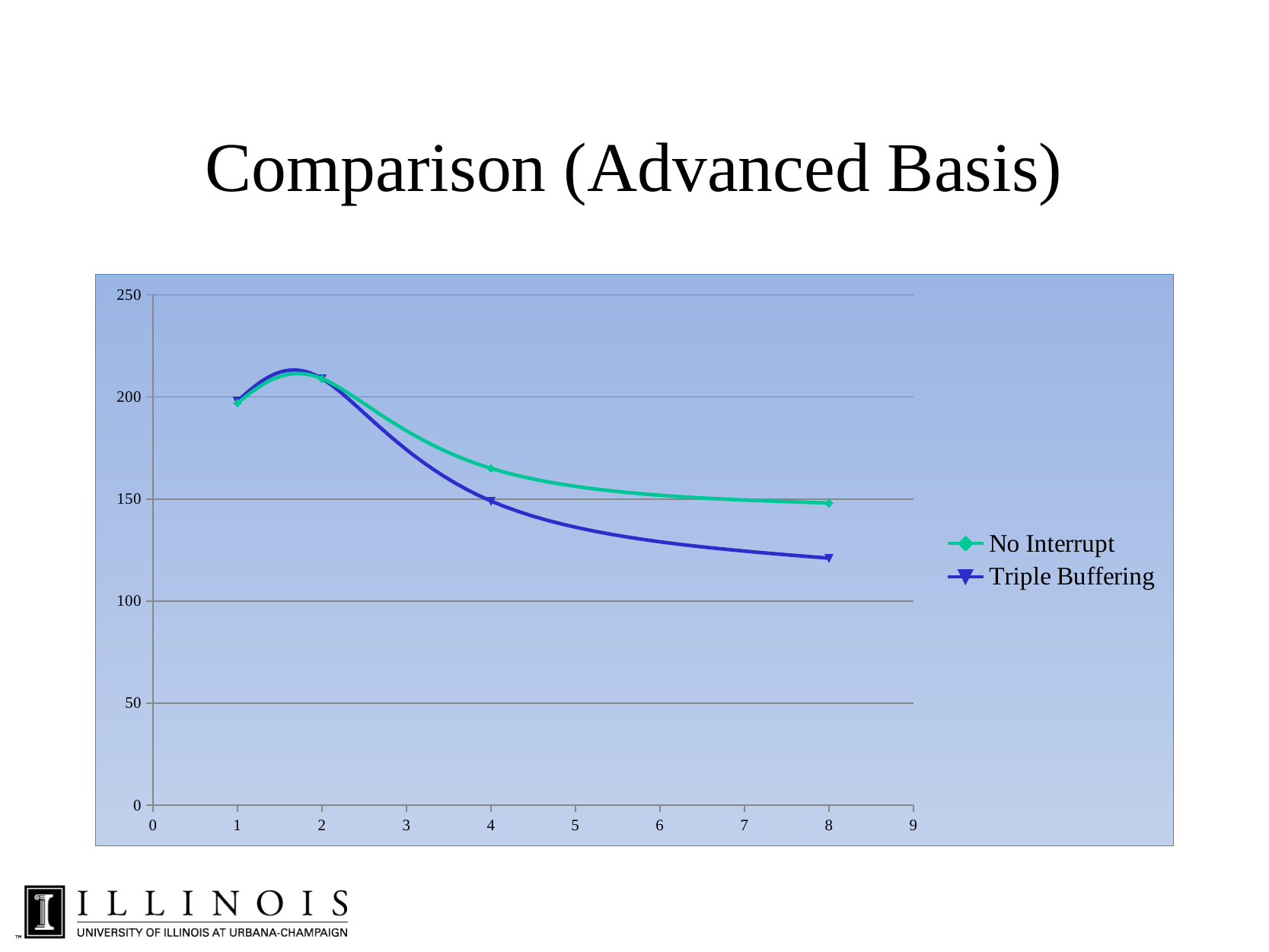
Is the value for Triple Buffering at x = 8 greater or less than 100? greater At x = 8, which series has the larger value, No Interrupt or Triple Buffering? No Interrupt At which x value does the Triple Buffering series reach its lowest point? 8 What are the names of the two series in the legend? No Interrupt and Triple Buffering Do the values of the No Interrupt series rise or fall from x = 2 to x = 8? fall How many data points are plotted for the Triple Buffering series? 4 How many series does the legend list? 2 Is the value for No Interrupt at x = 2 greater or less than 200? greater At x = 4, which series has the larger value, No Interrupt or Triple Buffering? No Interrupt Is the value for Triple Buffering at x = 8 greater or less than 150? less What kind of chart is shown on the slide? line chart